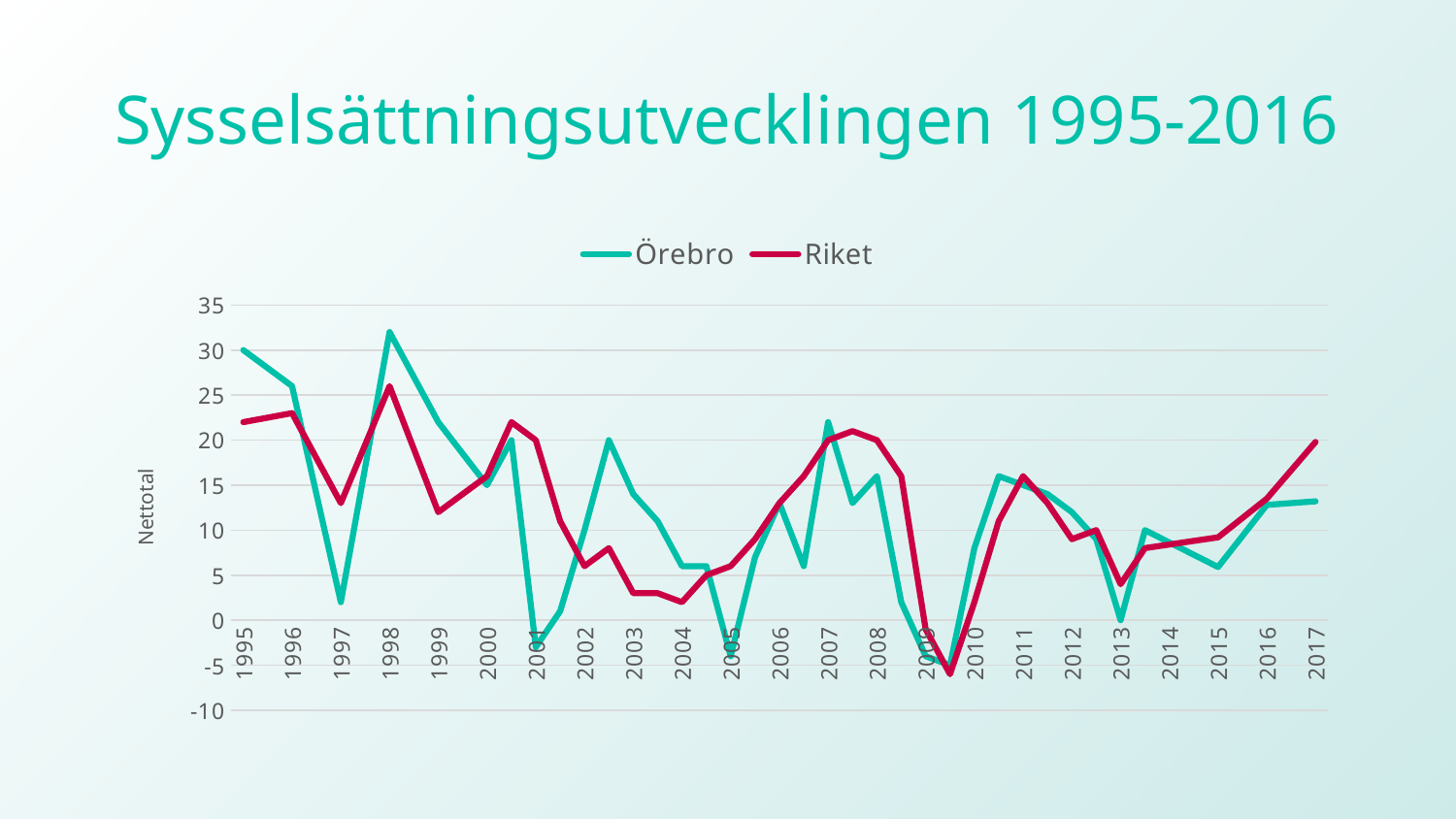
What is the title of the chart? Sysselsättningsutvecklingen 1995-2016 What is the label on the y axis? Nettotal How many series does the legend list? 2 Is the value for Örebro in 1998 greater or less than 30? greater In which year does the Örebro series reach its highest value? 1998 Which series has the larger value in 1995, Örebro or Riket? Örebro How many years are labelled on the x axis? 23 In which year does the Riket series reach its lowest value? 2009 In which year does the Örebro series reach its lowest value? 2009 What kind of chart is shown on the slide? line chart Which series has the larger value in 2017, Örebro or Riket? Riket